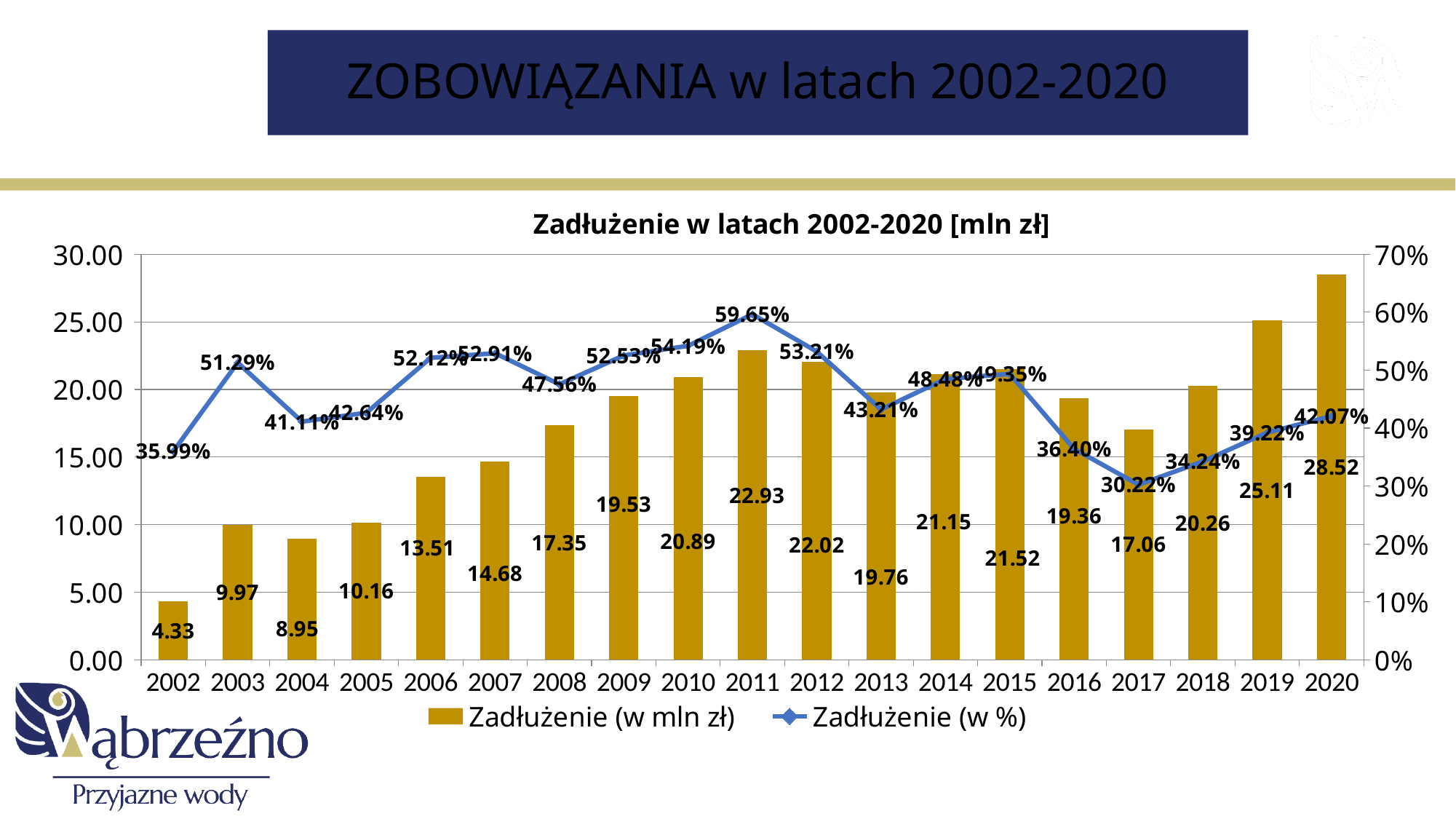
What is the value of Zadłużenie (w mln zł) for 2002? 4.33 How many years are shown on the x axis of the chart? 19 What kind of chart is used to show Zadłużenie (w mln zł)? Bar chart Which year has the larger Zadłużenie (w mln zł), 2012 or 2013? 2012 What is the difference in Zadłużenie (w mln zł) between 2020 and 2019? 3.41 How many series does the legend list? 2 Which year has the highest Zadłużenie (w mln zł)? 2020 What is the title of the chart? Zadłużenie w latach 2002-2020 [mln zł] What is the value of Zadłużenie (w %) for 2017? 30.22% What is the value of Zadłużenie (w mln zł) for 2011? 22.93 Which year has the highest Zadłużenie (w %)? 2011 Which year has the lowest Zadłużenie (w %)? 2017